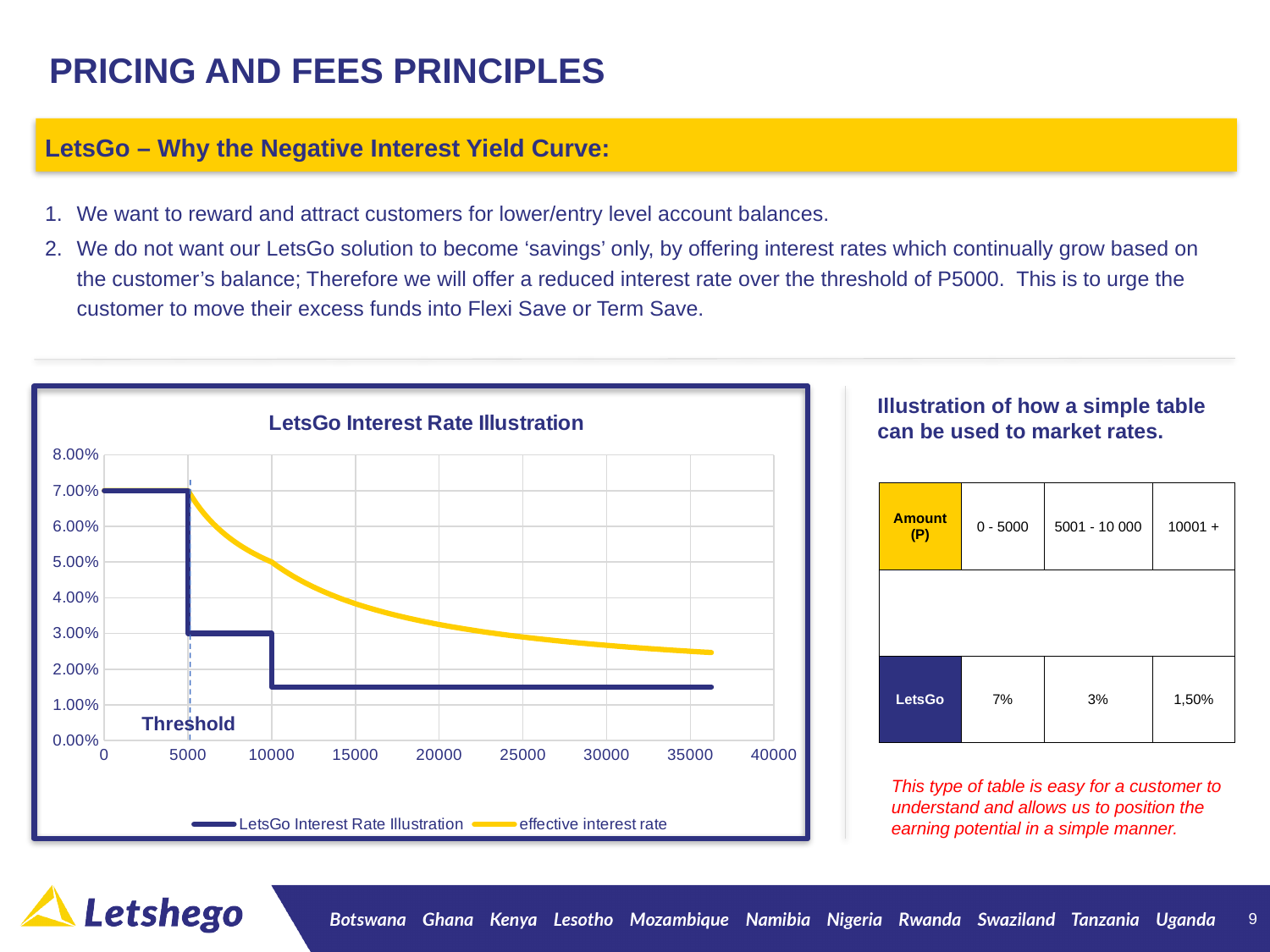
Does the effective interest rate rise or fall as the balance increases beyond 5000? fall Is the effective interest rate at a balance of 10000 greater or less than 4.00%? greater What is the title of the chart? LetsGo Interest Rate Illustration What is the value of the LetsGo Interest Rate Illustration series for balances between 0 and 5000? 7.00% At a balance of 20000, which series has the higher value: LetsGo Interest Rate Illustration or effective interest rate? effective interest rate Which series is drawn in yellow in the chart? effective interest rate What type of chart is shown on the slide? line chart What is the value of the LetsGo Interest Rate Illustration series for balances between 5000 and 10000? 3.00% By how much does the LetsGo Interest Rate Illustration series drop at the 5000 threshold? 4.00% Is the LetsGo Interest Rate Illustration value at a balance of 20000 greater or less than 2.00%? less Is the effective interest rate at a balance of 20000 greater or less than 4.00%? less How many series does the legend of the chart list? 2